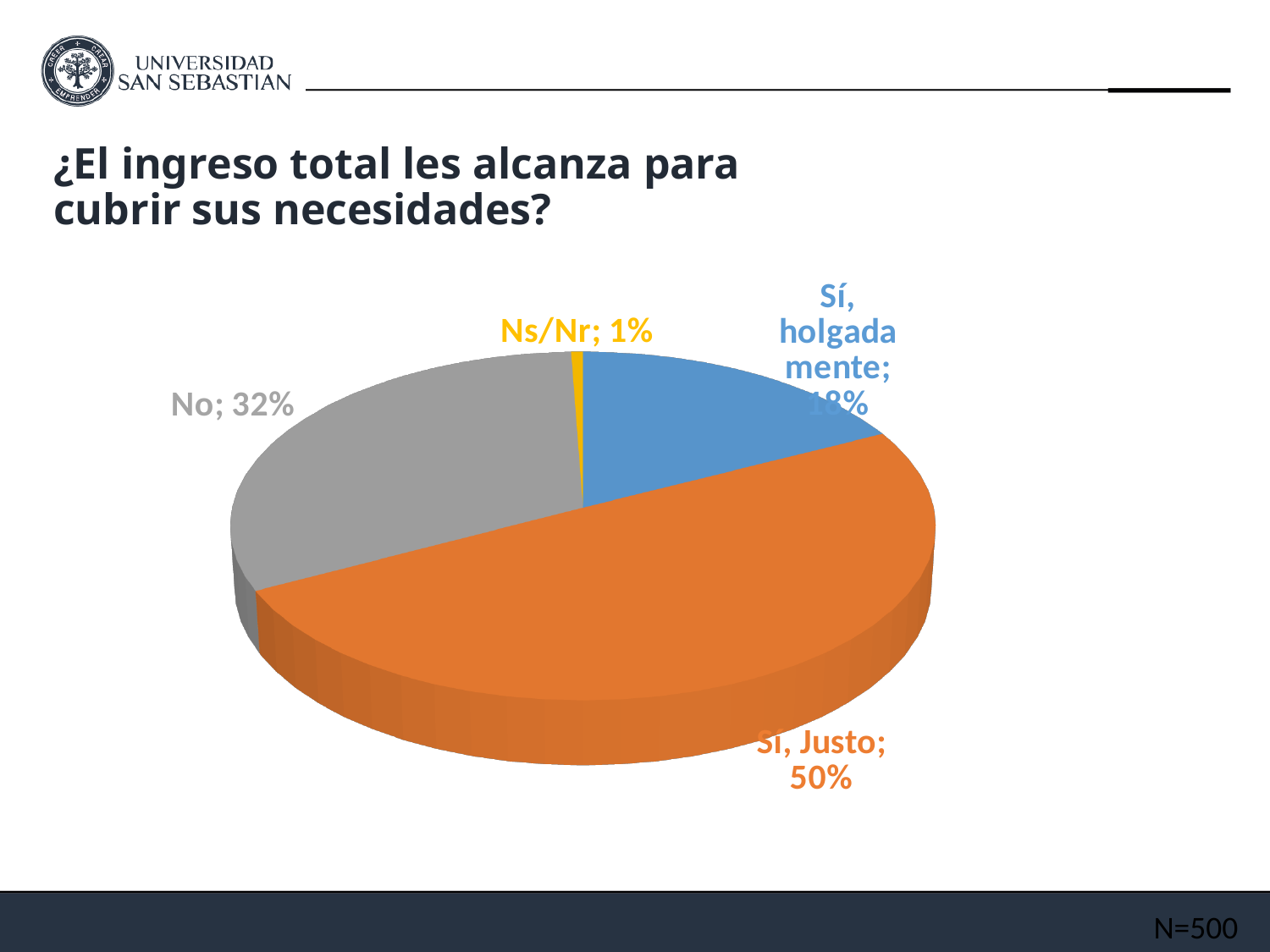
What kind of chart is shown on the slide? Pie chart What percentage of respondents answered "Ns/Nr"? 1% By how many percentage points does "Sí, Justo" exceed "No"? 18 percentage points Which slice is larger: "Sí, Justo" or "No"? Sí, Justo What share of the pie does the "No" slice represent? 32% How many slices does the pie chart have? 4 What percentage of respondents answered "No"? 32% What colour is the "Sí, Justo" slice? Orange Which response has the largest slice of the pie? Sí, Justo What percentage of respondents answered "Sí, Justo"? 50% Which slice is larger: "No" or "Sí, holgadamente"? No Which response has the smallest slice of the pie? Ns/Nr